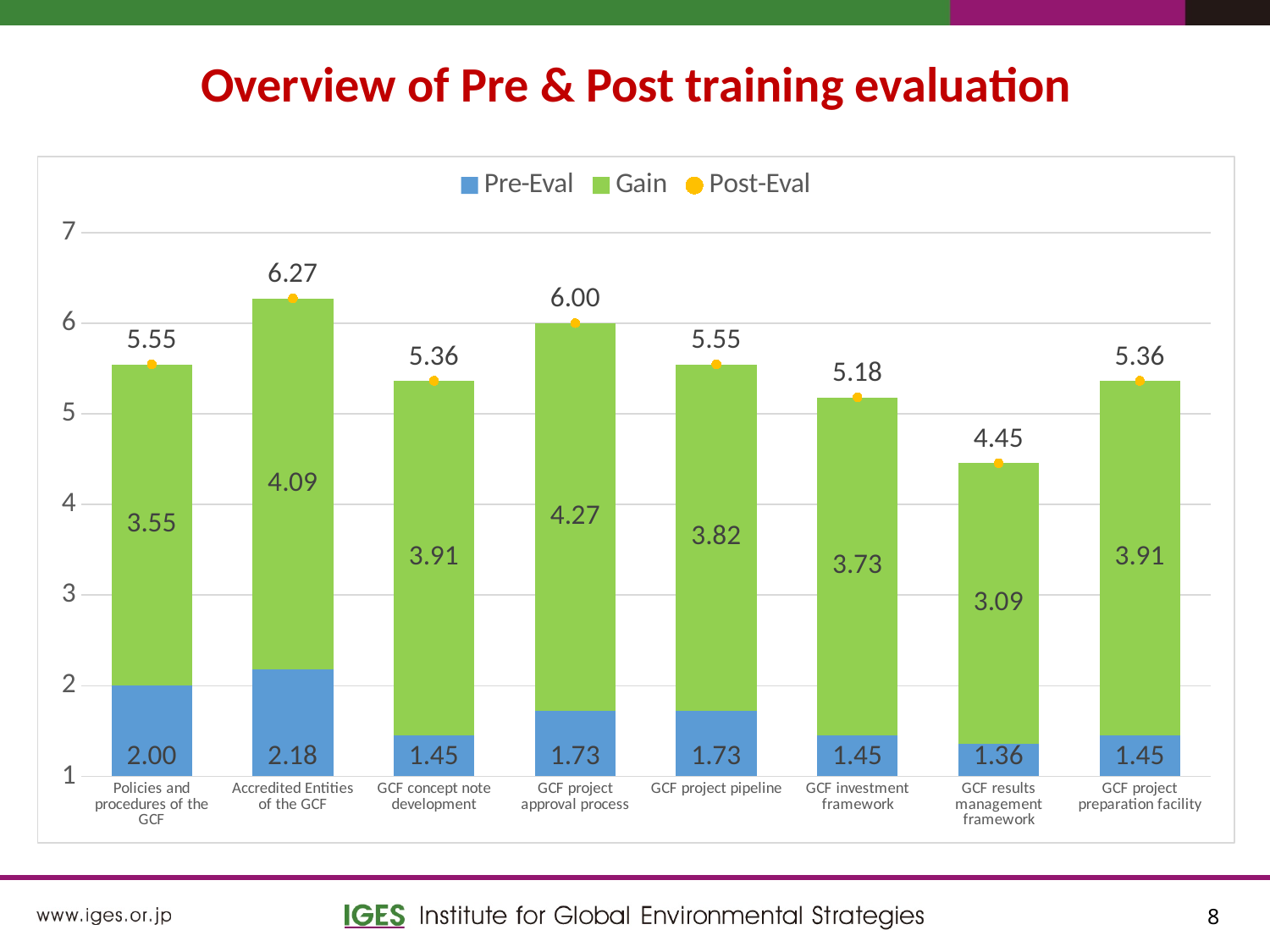
Which category has the lowest Pre-Eval value? GCF results management framework Which is larger, the Gain for GCF project pipeline or the Gain for GCF investment framework? GCF project pipeline How many series does the legend list? 3 What is the Gain value for GCF project approval process? 4.27 Is the Post-Eval value for GCF concept note development greater or less than 5? greater What is the difference between the Post-Eval values for GCF project approval process and GCF investment framework? 0.82 How many categories are shown on the x axis? 8 Which category has the highest Post-Eval value? Accredited Entities of the GCF What kind of chart is shown on the slide? Stacked bar chart What is the title of the slide? Overview of Pre & Post training evaluation What is the Pre-Eval value for Accredited Entities of the GCF? 2.18 What is the Post-Eval value for GCF results management framework? 4.45